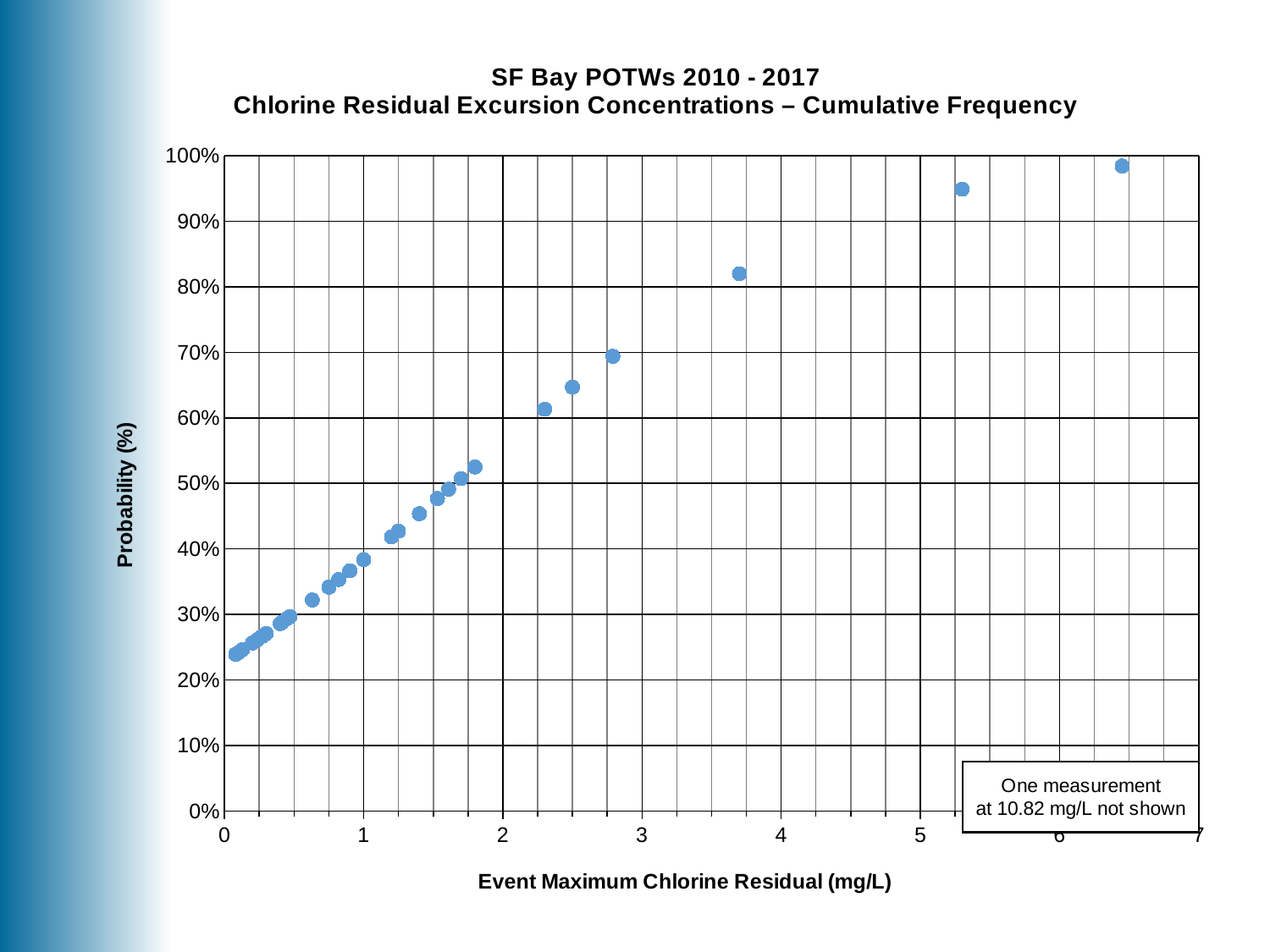
What kind of chart is shown on the slide? Scatter chart Is the event maximum chlorine residual for the point with the highest probability greater or less than 6 mg/L? greater Is the probability for the point at about 1 mg/L greater or less than 40%? less Is the probability for the point at about 3.7 mg/L greater or less than 80%? greater Which point has the higher probability: the one at about 2.5 mg/L or the one at about 3.7 mg/L? The one at about 3.7 mg/L What is the title of the chart? SF Bay POTWs 2010 - 2017 Chlorine Residual Excursion Concentrations – Cumulative Frequency What does the note in the lower right of the chart say? One measurement at 10.82 mg/L not shown Do the probability values rise or fall as the event maximum chlorine residual increases along the x axis? Rise